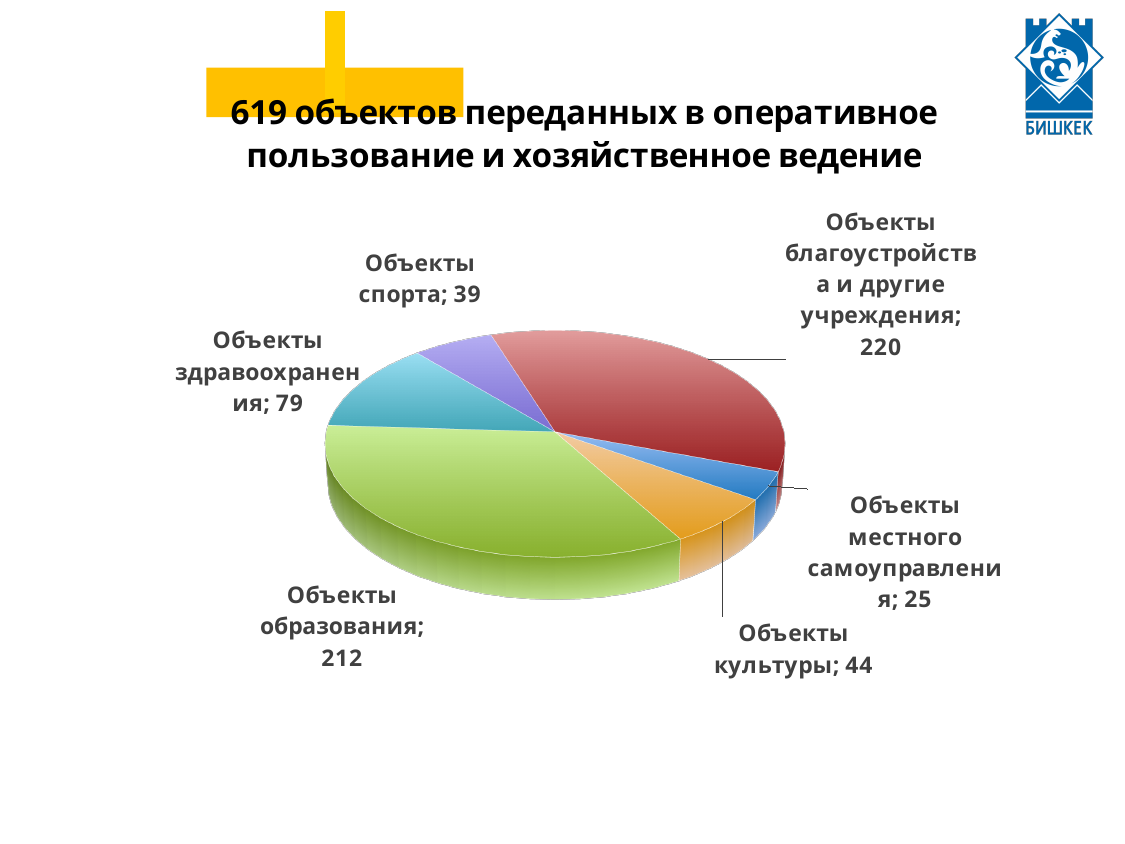
What is the value for Объекты местного самоуправления? 25 How many slices does the pie chart have? 6 What is the title of the chart on the slide? 619 объектов переданных в оперативное пользование и хозяйственное ведение Which category has the smallest value? Объекты местного самоуправления What kind of chart is shown on the slide? Pie chart What is the value for Объекты образования? 212 What is the difference between the values for Объекты благоустройства и другие учреждения and Объекты образования? 8 What is the value for Объекты культуры? 44 What is the value for Объекты здравоохранения? 79 Which is larger: the value for Объекты здравоохранения or the value for Объекты спорта? Объекты здравоохранения Which category has the largest value? Объекты благоустройства и другие учреждения What is the total of all slices in the pie chart? 619